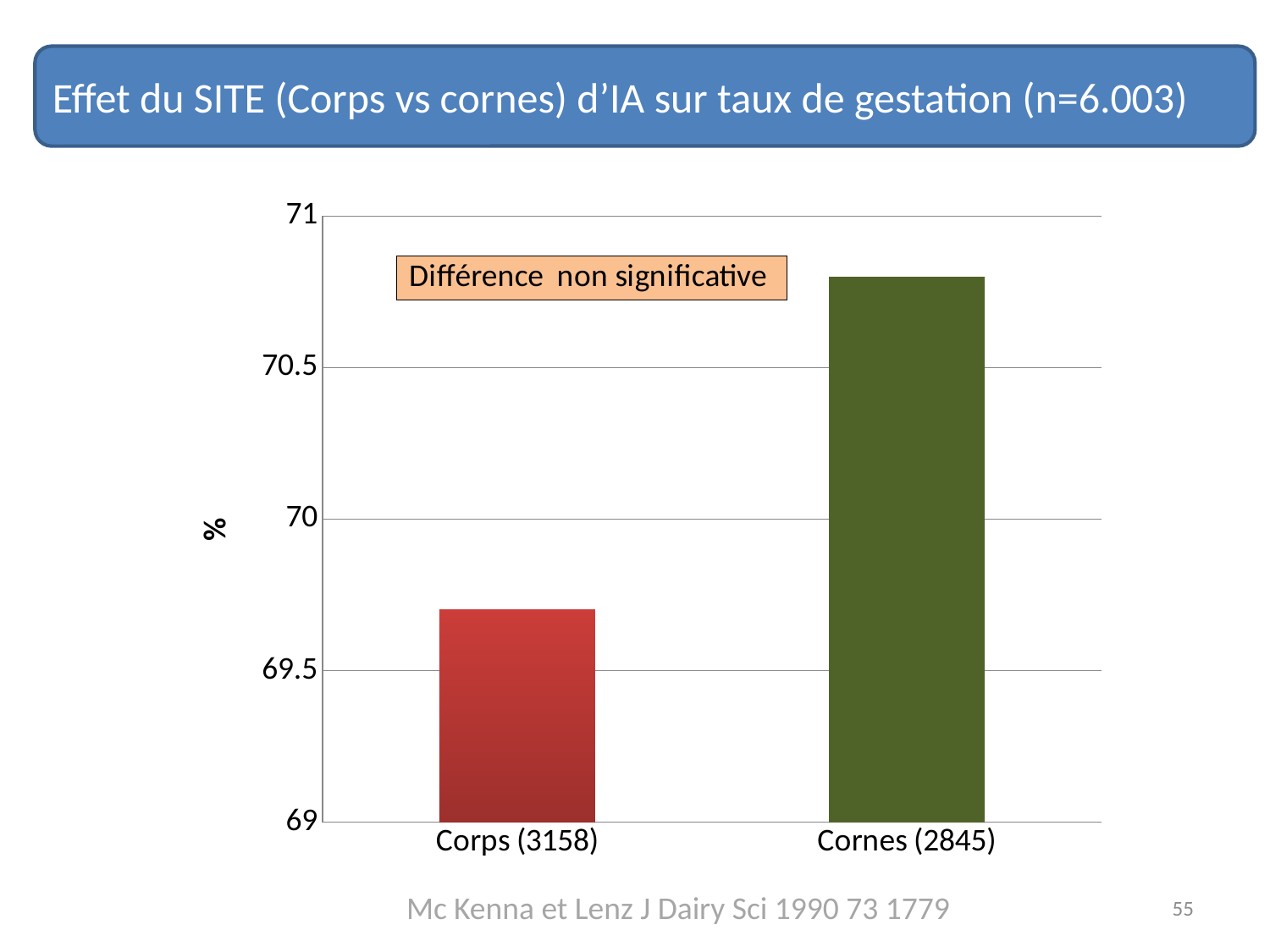
Which is larger, the value for Corps (3158) or the value for Cornes (2845)? Cornes (2845) Is the value for Corps (3158) greater or less than 69.5? greater How many categories are plotted on the x axis? 2 Is the value for Cornes (2845) greater or less than 71? less Which category has the lowest bar? Corps (3158) What is the label on the y axis of the chart? % Is the value for Corps (3158) greater or less than 70? less Which category has the highest bar? Cornes (2845) What kind of chart is shown on the slide? bar chart What does the text box inside the chart area say? Différence non significative